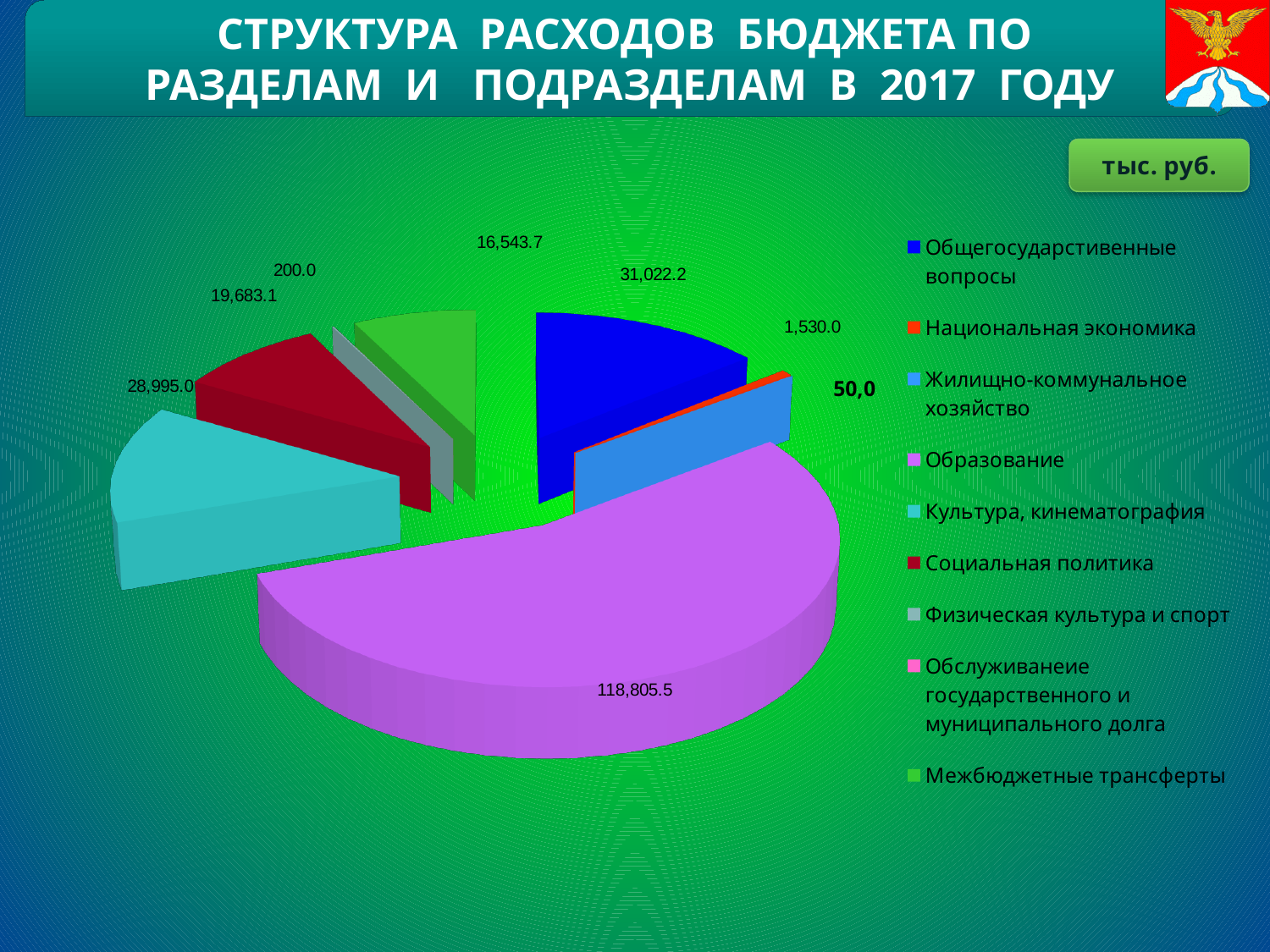
Which is larger, the value for Социальная политика or the value for Межбюджетные трансферты? Социальная политика How many categories does the legend of the pie chart list? 9 What is the difference between the values for Культура, кинематография and Социальная политика? 9,311.9 What is the value shown for Физическая культура и спорт? 200.0 What is the value shown for Межбюджетные трансферты? 16,543.7 What kind of chart is shown on the slide? pie chart What is the value shown for Образование? 118,805.5 Which category has the largest slice in the pie chart? Образование In what units are the values on the chart given, according to the label on the slide? тыс. руб. What is the value shown for Культура, кинематография? 28,995.0 What is the value shown for Социальная политика? 19,683.1 What is the value shown for Общегосударственные вопросы? 31,022.2